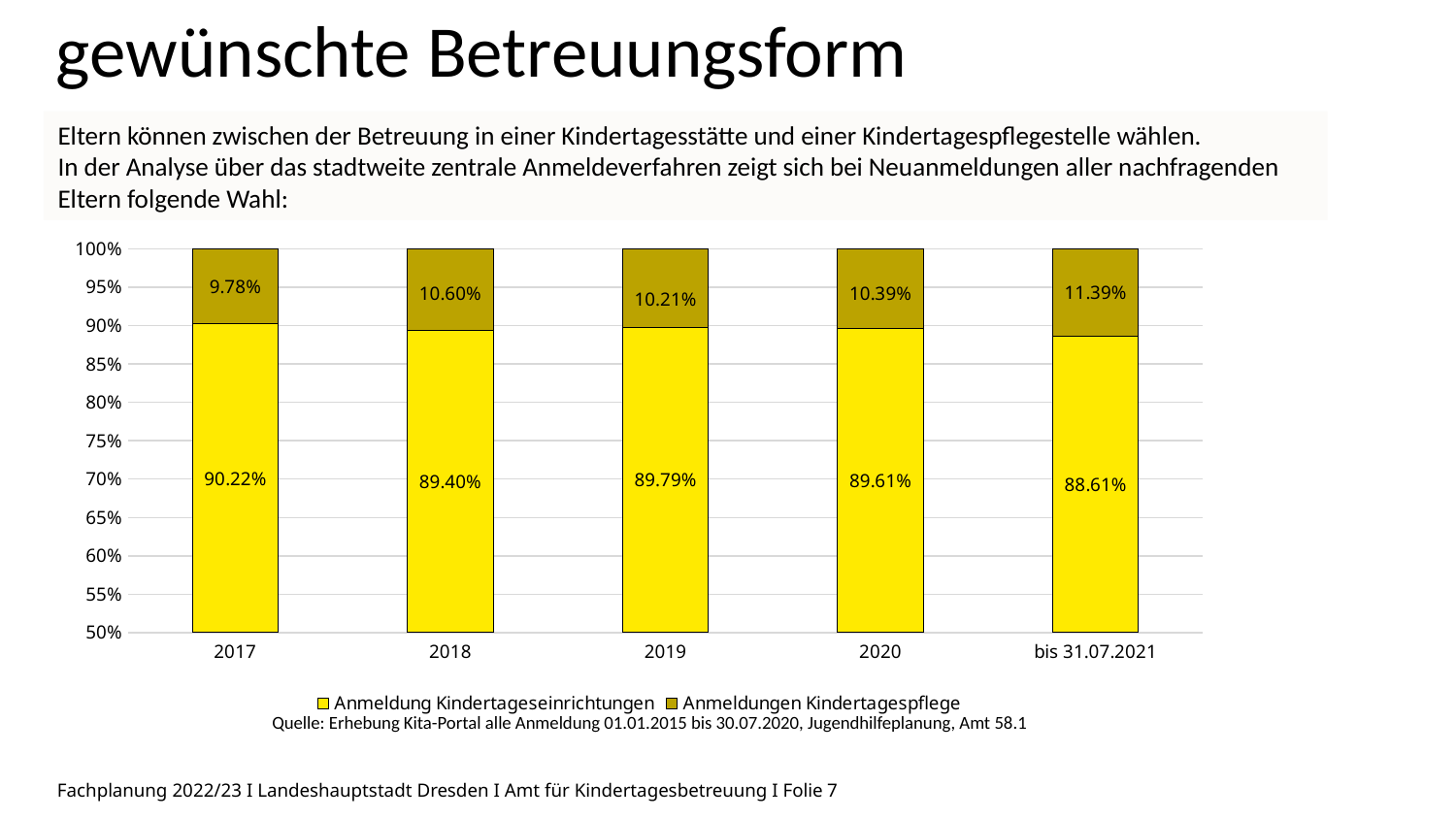
What is the total of the stacked bar for 2019? 100% Is the Anmeldungen Kindertagespflege value larger in 2018 or in 2019? 2018 What kind of chart is shown on the slide? Stacked bar chart Which year has the highest value for Anmeldungen Kindertagespflege? bis 31.07.2021 Which year has the lowest value for Anmeldungen Kindertagespflege? 2017 How many series does the legend list? 2 What is the value for Anmeldungen Kindertagespflege in 2020? 10.39% What is the value for Anmeldung Kindertageseinrichtungen for bis 31.07.2021? 88.61% Which year has the lowest value for Anmeldung Kindertageseinrichtungen? bis 31.07.2021 What is the value for Anmeldung Kindertageseinrichtungen in 2017? 90.22% What is the difference between the Anmeldung Kindertageseinrichtungen values for 2017 and 2018? 0.82% How many categories are shown on the x axis? 5